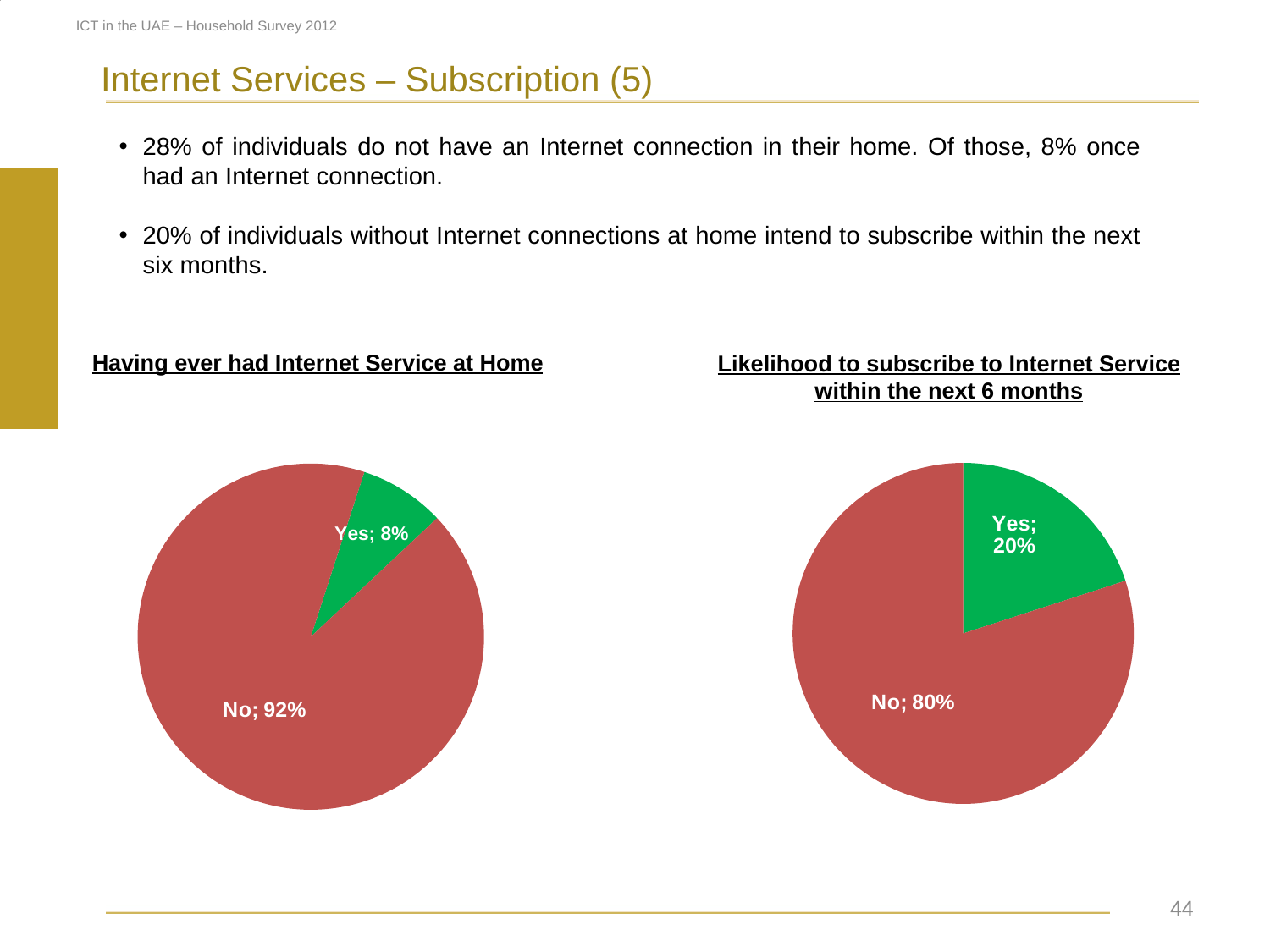
In the 'Having ever had Internet Service at Home' chart, what is the difference between 'No' and 'Yes'? 84% Which is larger: 'Yes' in the 'Having ever had Internet Service at Home' chart or 'Yes' in the 'Likelihood to subscribe to Internet Service within the next 6 months' chart? Yes in the Likelihood to subscribe chart What kind of chart is the 'Having ever had Internet Service at Home' chart? Pie chart In the 'Having ever had Internet Service at Home' chart, what colour is the 'Yes' slice? Green In the 'Likelihood to subscribe to Internet Service within the next 6 months' chart, what is the value for 'No'? 80% In the 'Having ever had Internet Service at Home' chart, which category is largest? No In the 'Likelihood to subscribe to Internet Service within the next 6 months' chart, which category is smallest? Yes In the 'Likelihood to subscribe to Internet Service within the next 6 months' chart, what share of the pie is 'Yes'? 20% In the 'Likelihood to subscribe to Internet Service within the next 6 months' chart, what is the difference between 'No' and 'Yes'? 60% In the 'Having ever had Internet Service at Home' chart, what is the value for 'No'? 92% How many slices does the 'Likelihood to subscribe to Internet Service within the next 6 months' pie chart have? 2 In the 'Having ever had Internet Service at Home' chart, what share of the pie is 'Yes'? 8%